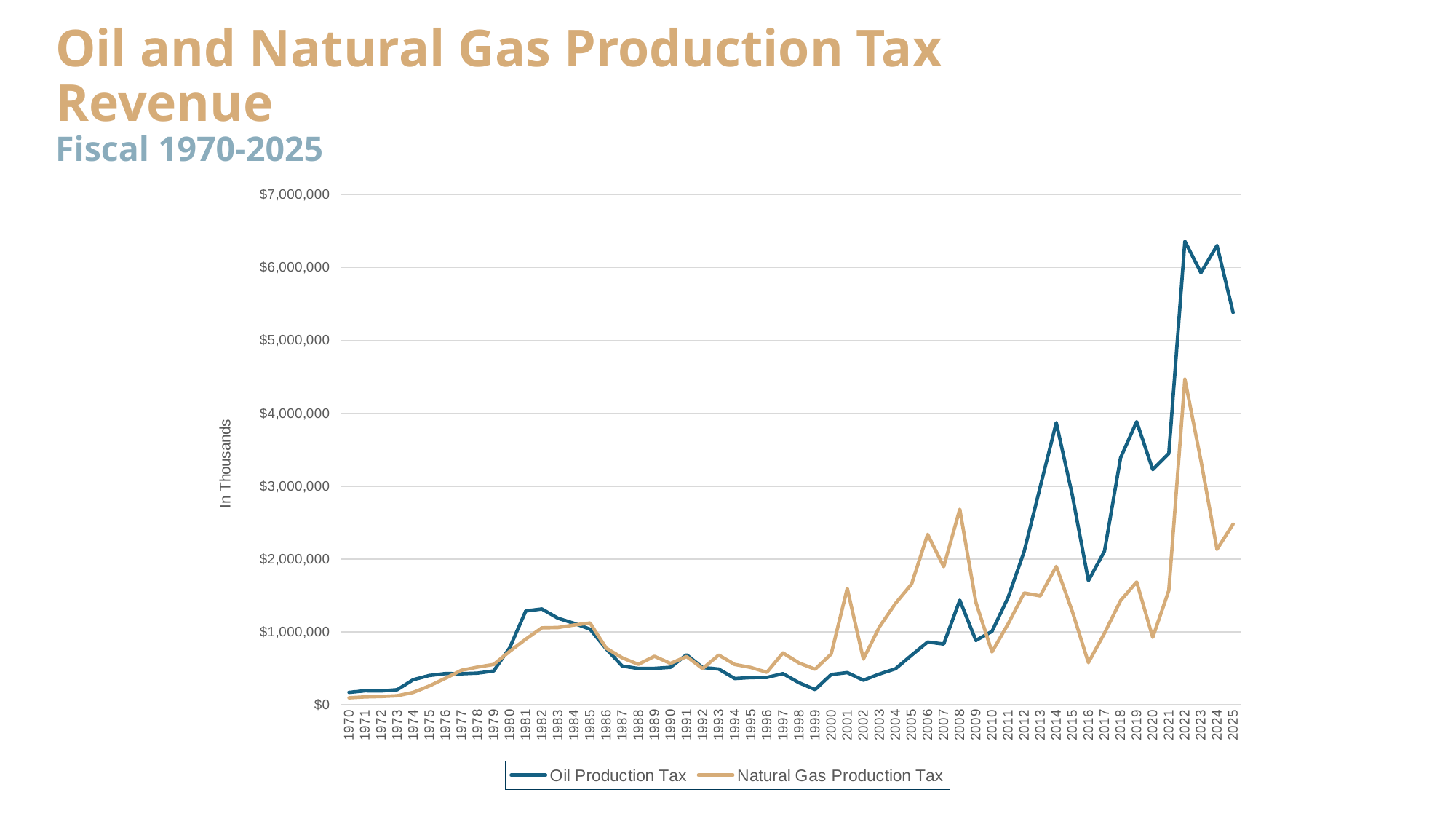
In 2008, which series has the larger value, Oil Production Tax or Natural Gas Production Tax? Natural Gas Production Tax Is the Oil Production Tax value for 2022 greater or less than $6,000,000? greater What kind of chart is shown on the slide? Line chart Is the Oil Production Tax value for 2016 greater or less than $2,000,000? less Does the Oil Production Tax rise or fall from 2020 to 2022? rise What are the two series named in the legend? Oil Production Tax and Natural Gas Production Tax How many series does the legend list? 2 In which year does the Natural Gas Production Tax reach its highest value? 2022 Is the Natural Gas Production Tax value for 2022 greater or less than $4,000,000? greater In 2025, which series has the larger value, Oil Production Tax or Natural Gas Production Tax? Oil Production Tax What is the label on the vertical axis? In Thousands How many fiscal years are plotted along the x axis? 56